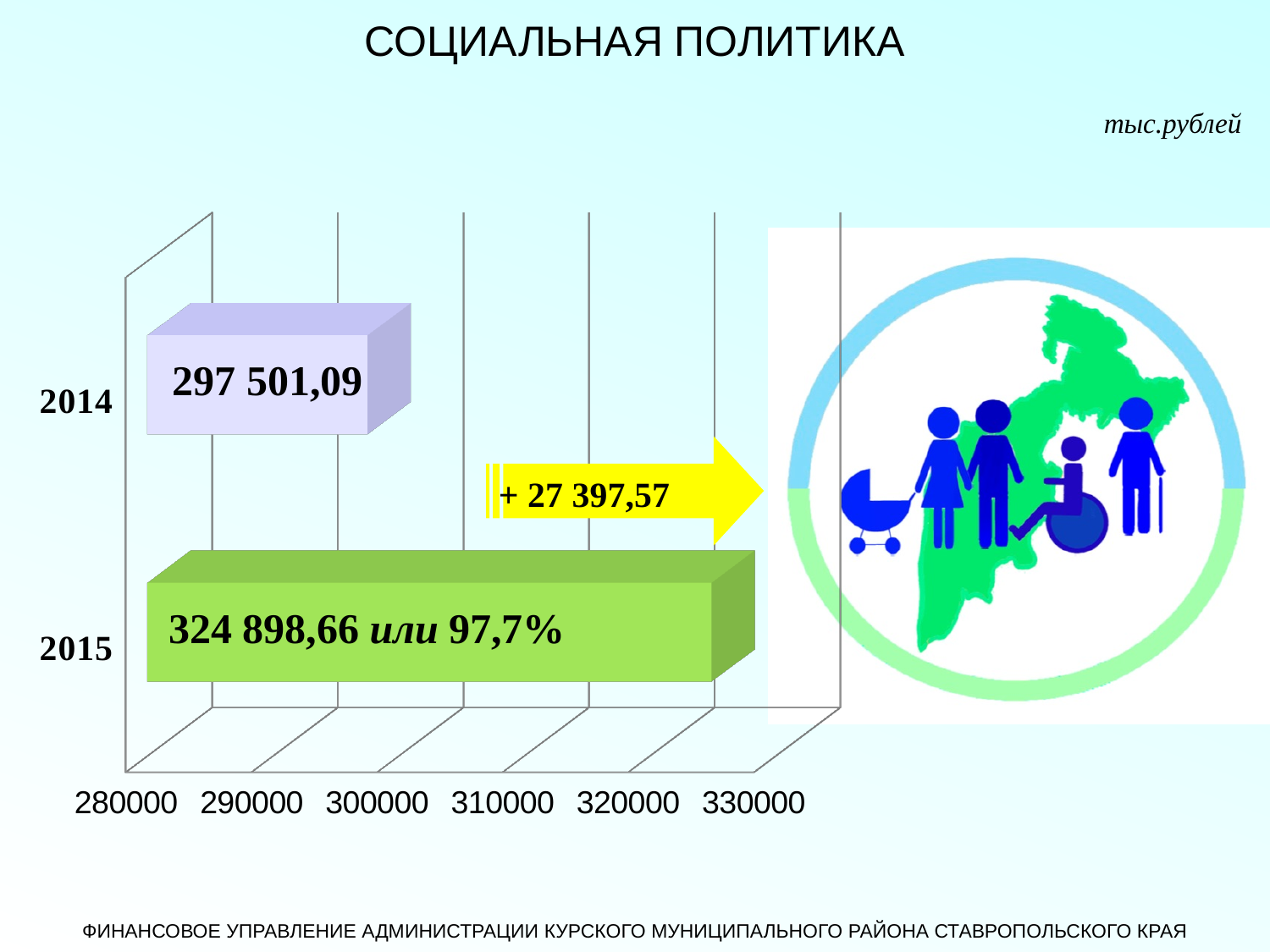
What is the value for 2014? 297 501,09 Which year has the lower value? 2014 What kind of chart is shown on the slide? bar chart Is the value for 2015 greater or less than 320000? greater Is the value for 2014 larger or smaller than the value for 2015? smaller Is the value for 2014 greater or less than 300000? less What unit of measurement is indicated for the chart? тыс.рублей What percentage is shown next to the 2015 value? 97,7% What is the value for 2015? 324 898,66 What is the difference between the 2015 and 2014 values, as shown on the slide? 27 397,57 Which year has the higher value? 2015 How many years (categories) are shown in the chart? 2